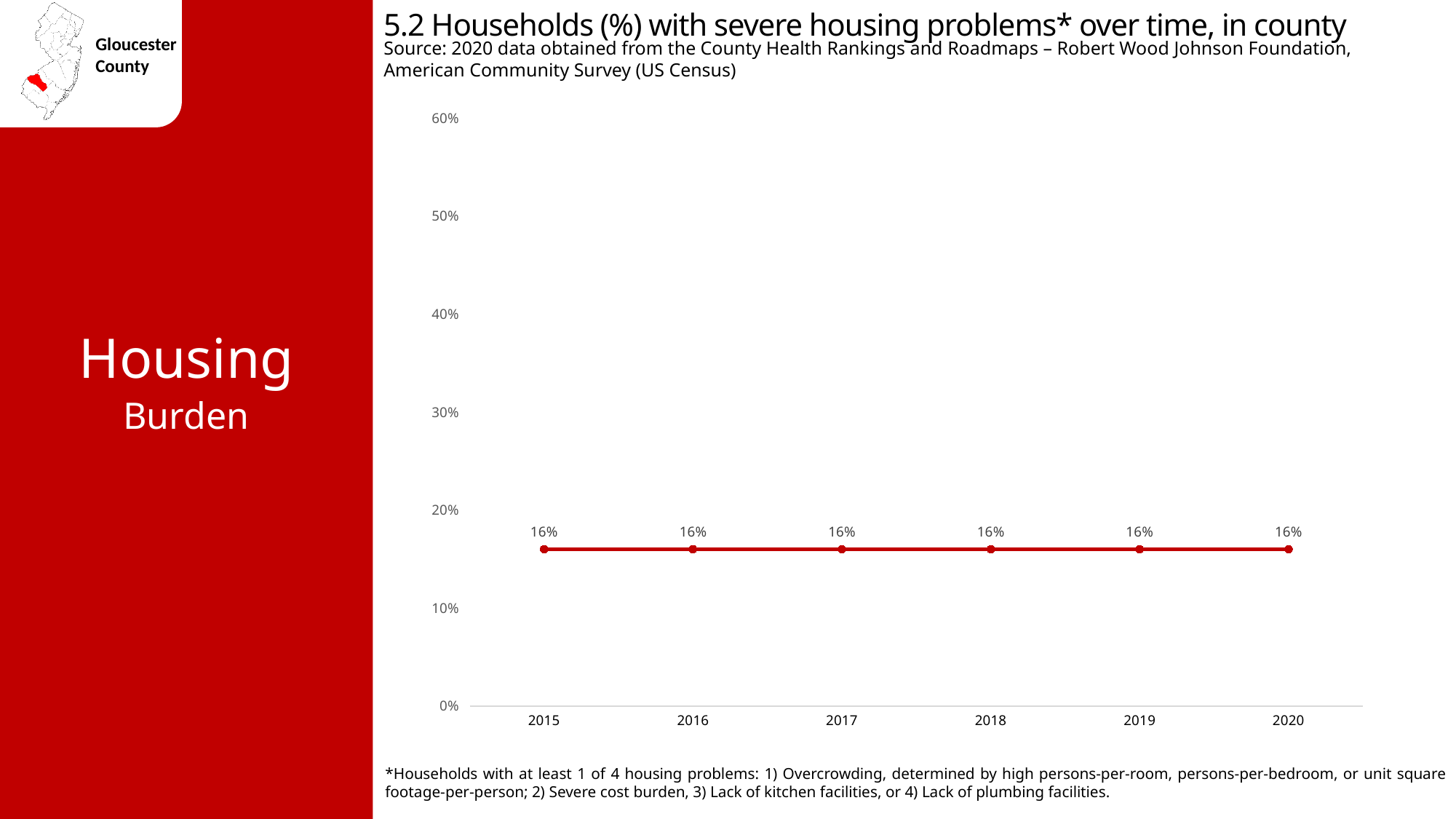
What percentage of households had severe housing problems in 2015? 16% Do the values rise, fall, or stay flat from 2015 to 2020? stay flat What is the highest value shown on the y axis? 60% How many years are plotted on the chart? 6 What is the difference between the 2015 value and the 2020 value? 0% What kind of chart is shown on the slide? line chart Is the value for 2017 greater or less than 20%? less What is the value plotted for 2020? 16% What is the value plotted for 2018? 16% Is the value for 2019 greater or less than 10%? greater What is the first year shown on the x axis? 2015